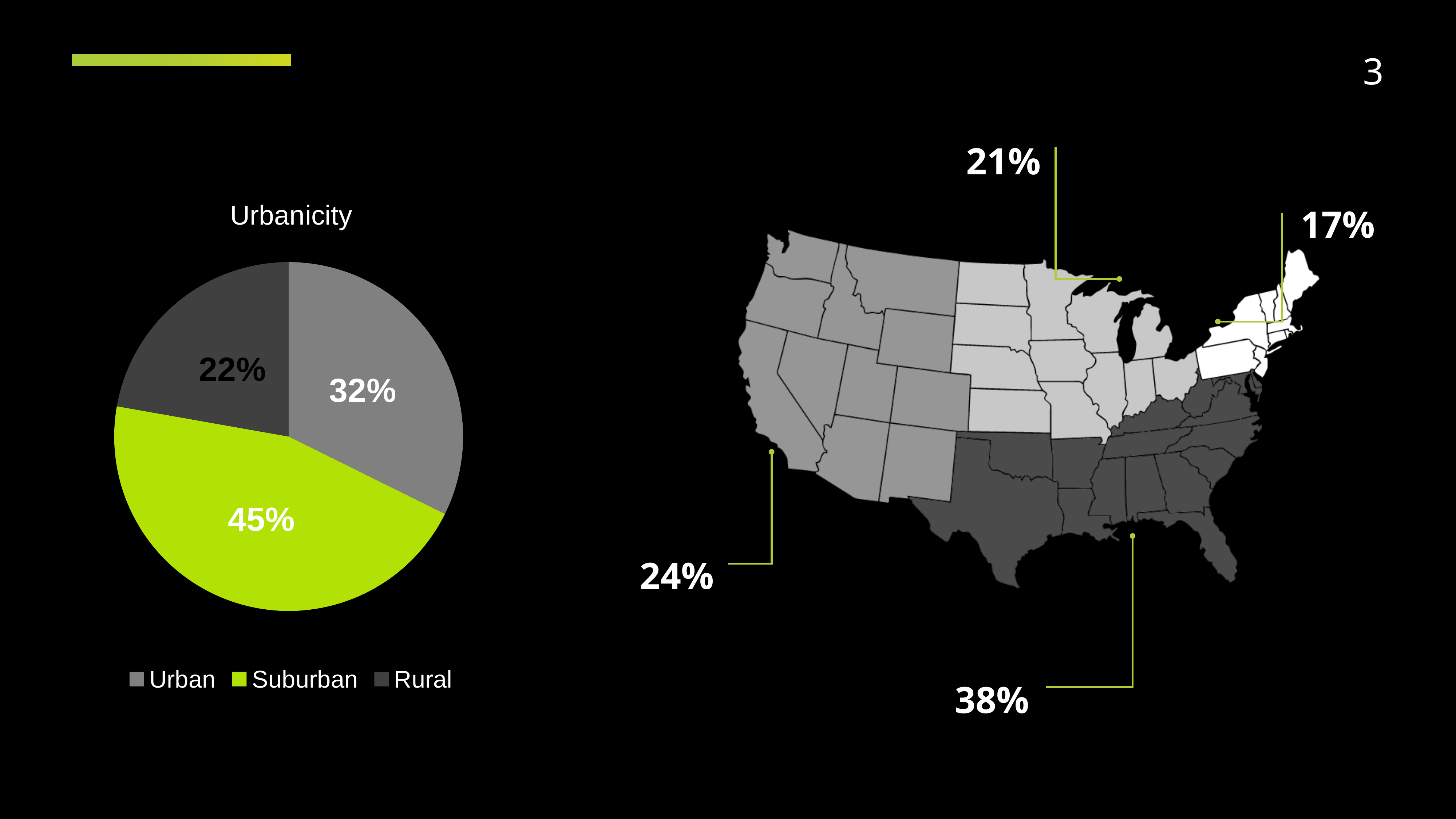
In the Urbanicity pie chart, which is larger, Urban or Rural? Urban In the Urbanicity pie chart, which category has the smallest share? Rural On the US map on the right, what percentage is shown for the dark grey southern region? 38% How many categories does the Urbanicity pie chart show? 3 What is the title of the pie chart on the left of the slide? Urbanicity What kind of chart is the chart on the left of the slide? Pie chart In the Urbanicity pie chart, what is the difference in percentage points between Suburban and Urban? 13% In the Urbanicity pie chart, which category has the largest share? Suburban In the Urbanicity pie chart, what percentage is shown for Urban? 32% In the Urbanicity pie chart, what percentage is shown for Rural? 22% In the Urbanicity pie chart, what is the difference in percentage points between Urban and Rural? 10% In the Urbanicity pie chart, what percentage is shown for Suburban? 45%